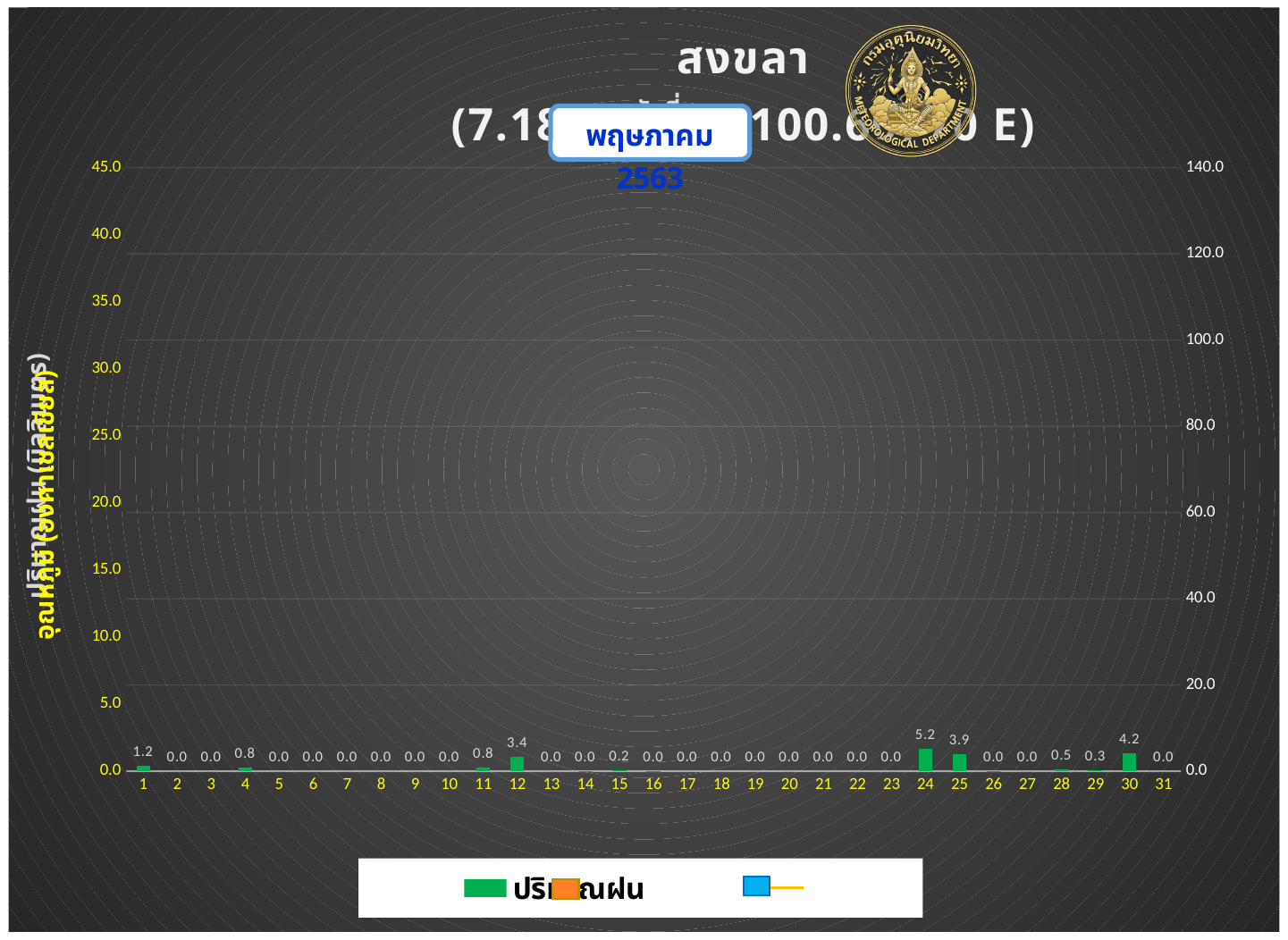
Is the value for day 24 greater or less than 5.0? greater What is the difference between the values for day 30 and day 12? 0.8 What is the value shown for day 1? 1.2 Which day has the highest value? 24 Which is larger, the value for day 25 or the value for day 30? day 30 What is the value shown for day 12? 3.4 What is the difference between the values for day 24 and day 25? 1.3 What is the value shown for day 24? 5.2 What colour are the bars in the chart? green What is the value shown for day 30? 4.2 What kind of chart is shown on the slide? bar chart How many days are shown on the x axis? 31